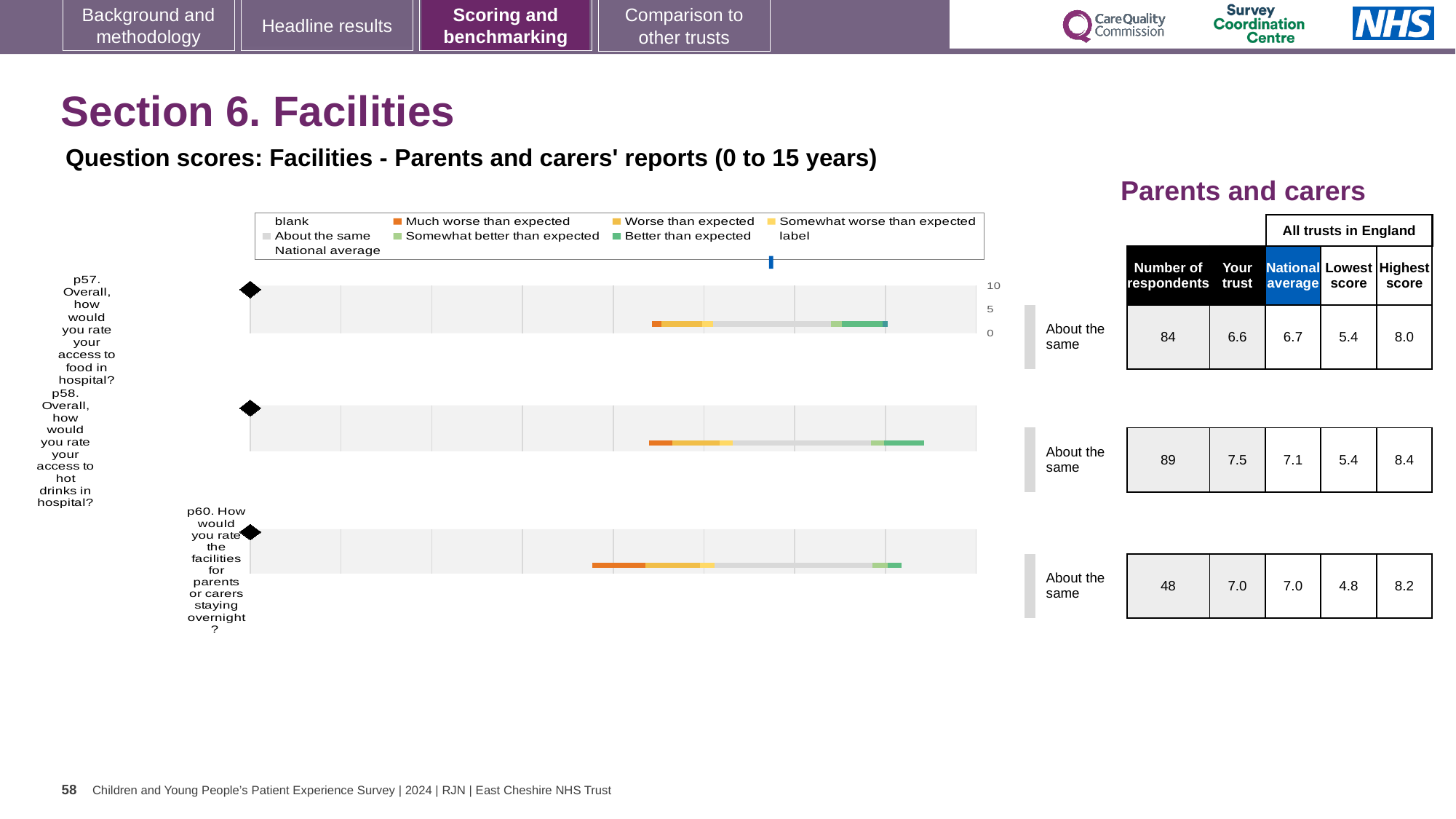
What is the difference between the highest score and the lowest score for p57? 2.6 What is the lowest score across all trusts in England for p60? 4.8 What is the highest score across all trusts in England for p58? 8.4 How many questions are plotted in the chart on this slide? 3 What is the national average score for p60 (facilities for parents or carers staying overnight)? 7.0 What is the 'Your trust' score for p57 (access to food in hospital)? 6.6 Which legend category is shown in orange? Much worse than expected What is the number of respondents for p58 (access to hot drinks in hospital)? 89 Which question has the fewest respondents? p60 Which question has the highest 'Your trust' score? p58 What kind of chart is used to show the question scores on this slide? bar chart For p58, is the 'Your trust' score higher or lower than the national average? higher